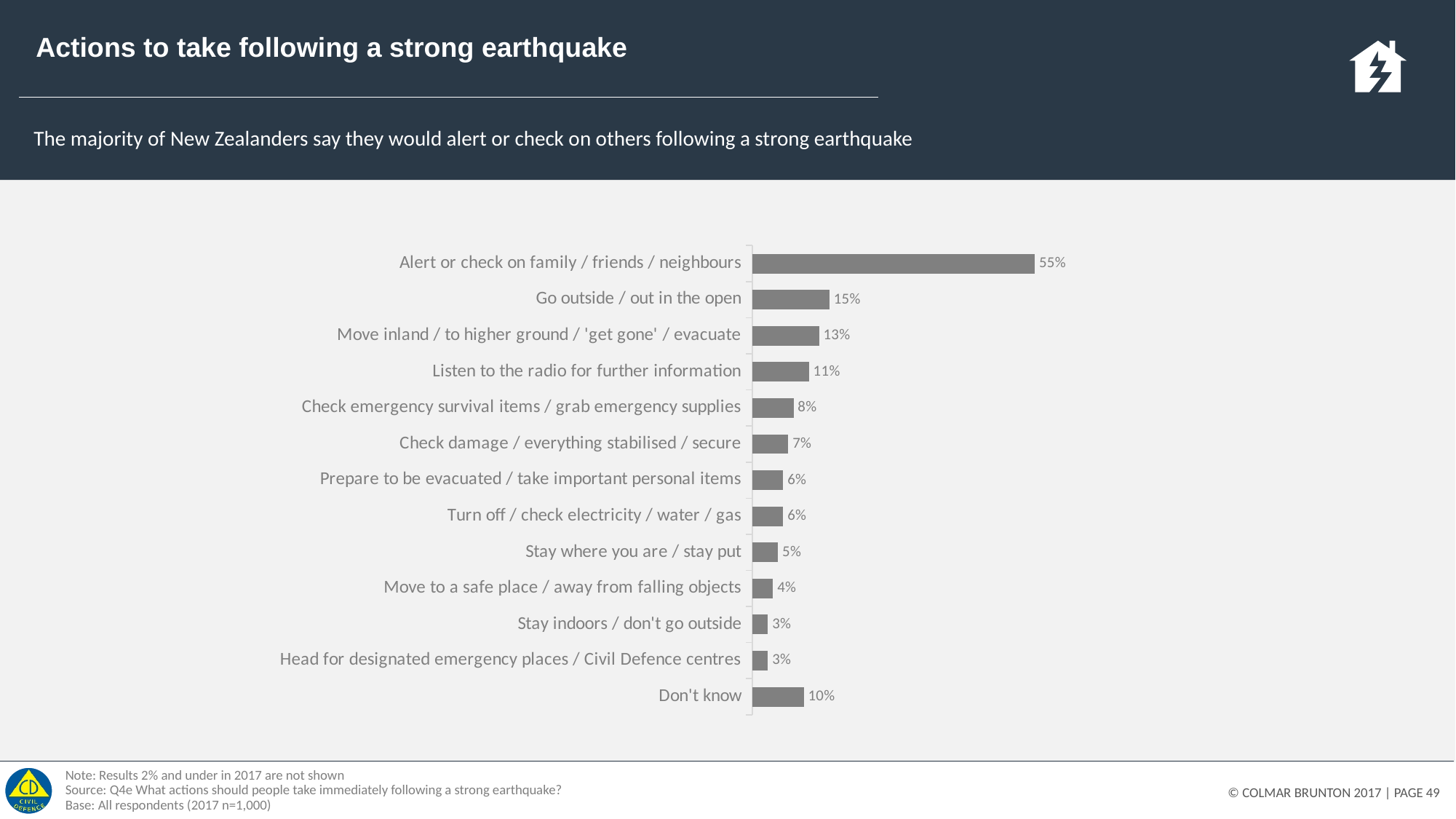
Which action has the highest percentage? Alert or check on family / friends / neighbours What is the value for 'Don't know'? 10% What is the value for 'Go outside / out in the open'? 15% What is the difference between 'Alert or check on family / friends / neighbours' and 'Go outside / out in the open'? 40% What percentage say they would listen to the radio for further information? 11% Which is larger: 'Check damage / everything stabilised / secure' or 'Move to a safe place / away from falling objects'? Check damage / everything stabilised / secure What percentage of respondents say they would alert or check on family / friends / neighbours following a strong earthquake? 55% What kind of chart is shown on the slide? Bar chart What is the title of the slide? Actions to take following a strong earthquake Which is larger: 'Stay where you are / stay put' or 'Don't know'? Don't know How many categories are shown in the chart? 13 What is the difference between 'Move inland / to higher ground / 'get gone' / evacuate' and 'Check emergency survival items / grab emergency supplies'? 5%